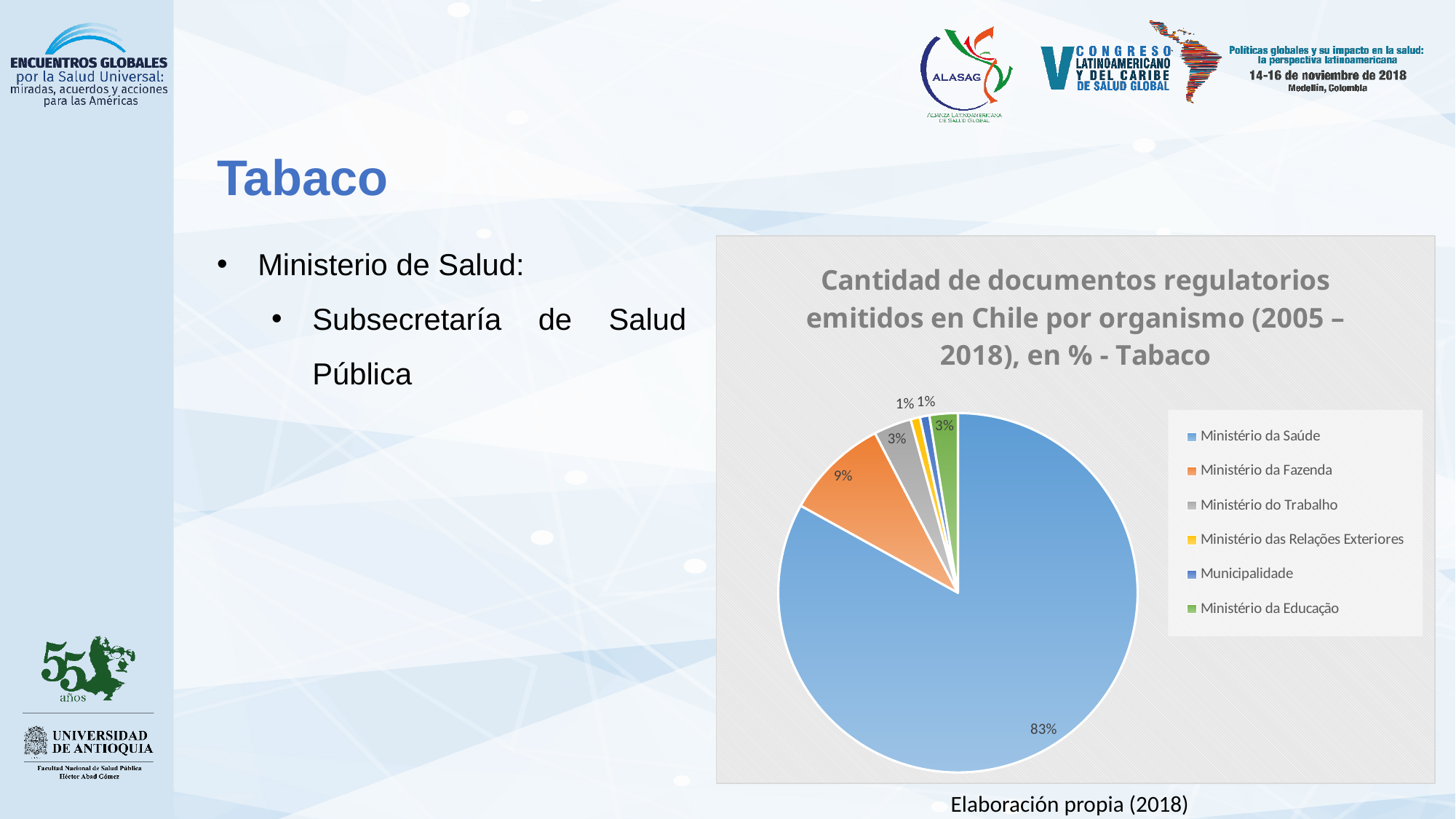
Which is larger, the share for Ministério da Fazenda or the share for Ministério do Trabalho? Ministério da Fazenda What share of the pie does Ministério da Saúde hold? 83% What colour is the slice for Ministério da Fazenda? orange How many slices does the pie chart have? 6 What is the value shown for Ministério do Trabalho? 3% What is the value shown for Ministério da Educação? 3% How many entries does the legend list? 6 What is the value shown for Ministério da Fazenda? 9% What is the value shown for Municipalidade? 1% Which organism has the largest slice of the pie? Ministério da Saúde What type of chart is shown on the slide? pie chart What is the difference between the shares of Ministério da Saúde and Ministério da Fazenda? 74%